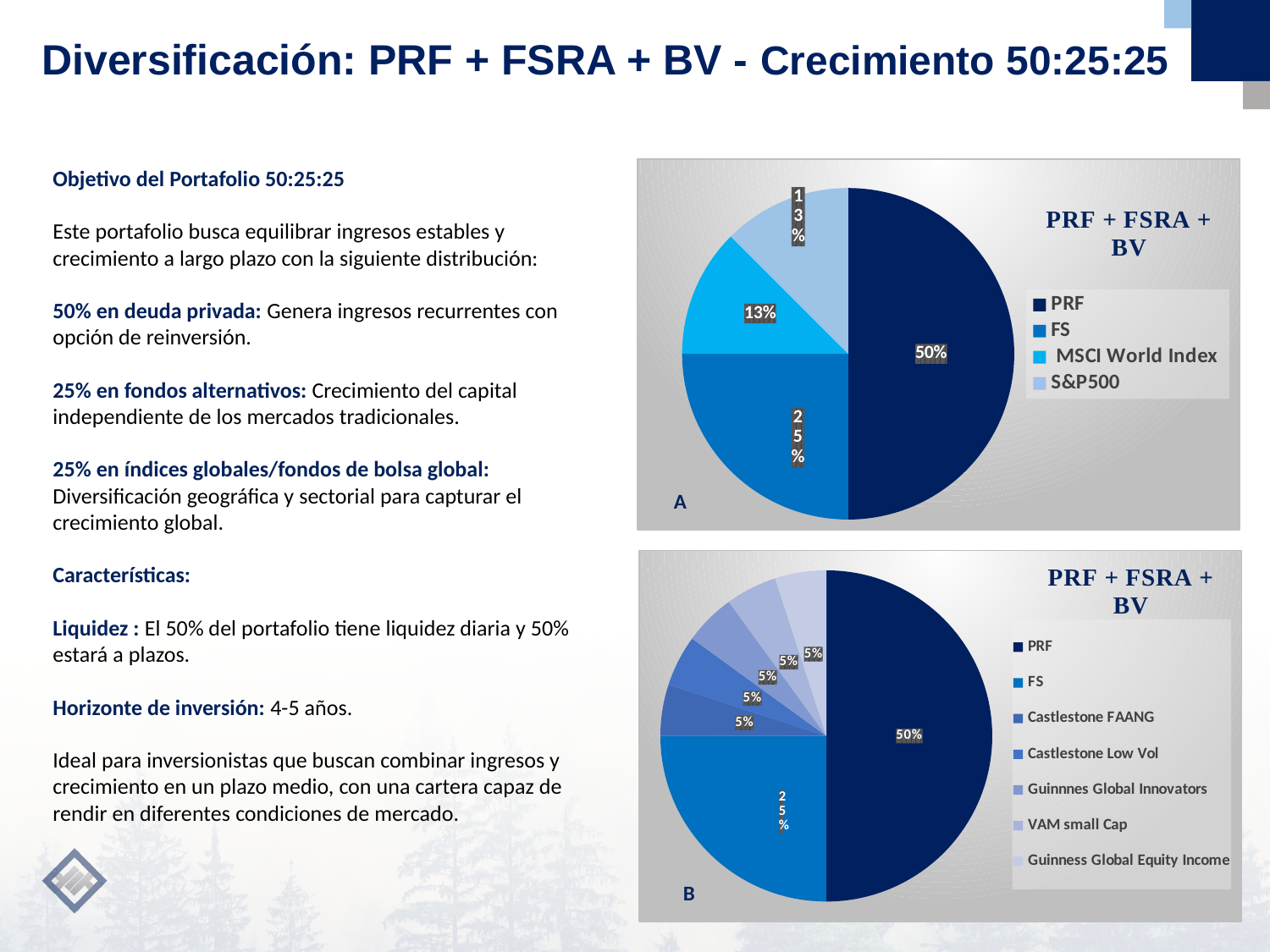
In the top chart (A), what share of the pie does FS have? 25% What is the title of the bottom chart (B)? PRF + FSRA + BV In the top chart (A), what share of the pie does PRF have? 50% In the bottom chart (B), how many entries does the legend list? 7 What kind of chart is the top chart (A) on the slide? pie chart In the bottom chart (B), what share of the pie does FS have? 25% In the top chart (A), which category has the largest slice? PRF In the bottom chart (B), which is larger, the share for PRF or the share for VAM small Cap? PRF In the top chart (A), how many entries does the legend list? 4 In the top chart (A), what is the difference between the PRF share and the FS share? 25%